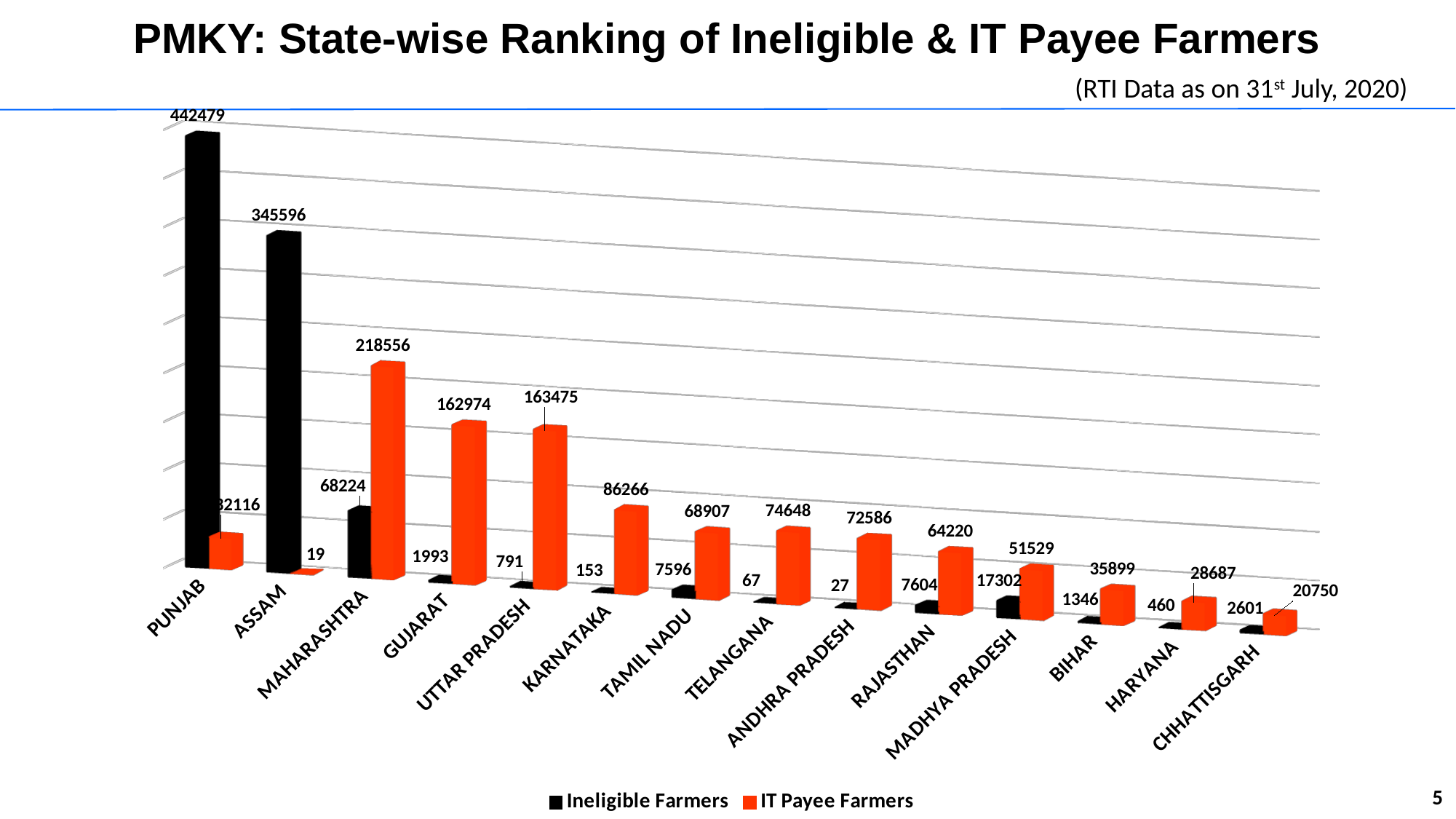
What is the number of IT Payee Farmers for Assam? 19 What is the number of Ineligible Farmers for Madhya Pradesh? 17302 Which state has the highest number of IT Payee Farmers? MAHARASHTRA Which state has the lowest number of IT Payee Farmers? ASSAM Which has more Ineligible Farmers, Madhya Pradesh or Tamil Nadu? Madhya Pradesh What is the difference between the Ineligible Farmers values for Punjab and Assam? 96883 What is the number of IT Payee Farmers for Maharashtra? 218556 How many states are shown on the x axis? 14 How many series does the legend list? 2 Which state has the highest number of Ineligible Farmers? PUNJAB What is the number of Ineligible Farmers for Punjab? 442479 What kind of chart is shown on the slide? Bar chart